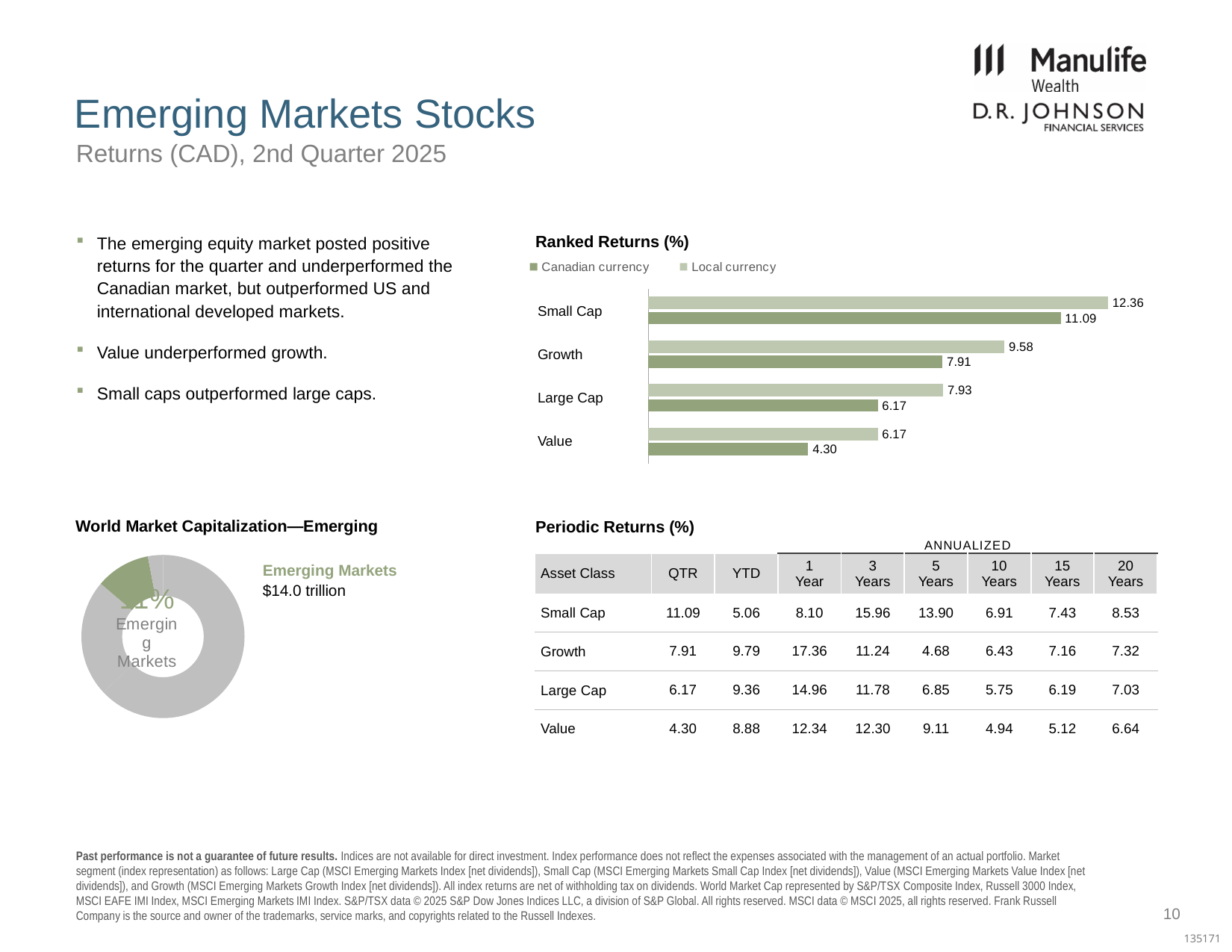
In the Ranked Returns (%) chart, what is the difference between the Local currency and Canadian currency returns for Small Cap? 1.27 In the Ranked Returns (%) chart, which is larger: the Local currency return for Large Cap or the Canadian currency return for Growth? Local currency return for Large Cap In the Ranked Returns (%) chart, which category has the lowest Canadian currency return? Value What kind of chart is the World Market Capitalization—Emerging chart? Donut chart In the Ranked Returns (%) chart, what is the Local currency return for Growth? 9.58 In the Ranked Returns (%) chart, what is the difference between the Canadian currency returns for Growth and Large Cap? 1.74 How many categories are shown in the Ranked Returns (%) chart? 4 What kind of chart is the Ranked Returns (%) chart? Bar chart How many series does the legend of the Ranked Returns (%) chart list? 2 In the Ranked Returns (%) chart, what is the Canadian currency return for Small Cap? 11.09 In the Ranked Returns (%) chart, what is the Canadian currency return for Value? 4.30 In the Ranked Returns (%) chart, which category has the highest Local currency return? Small Cap